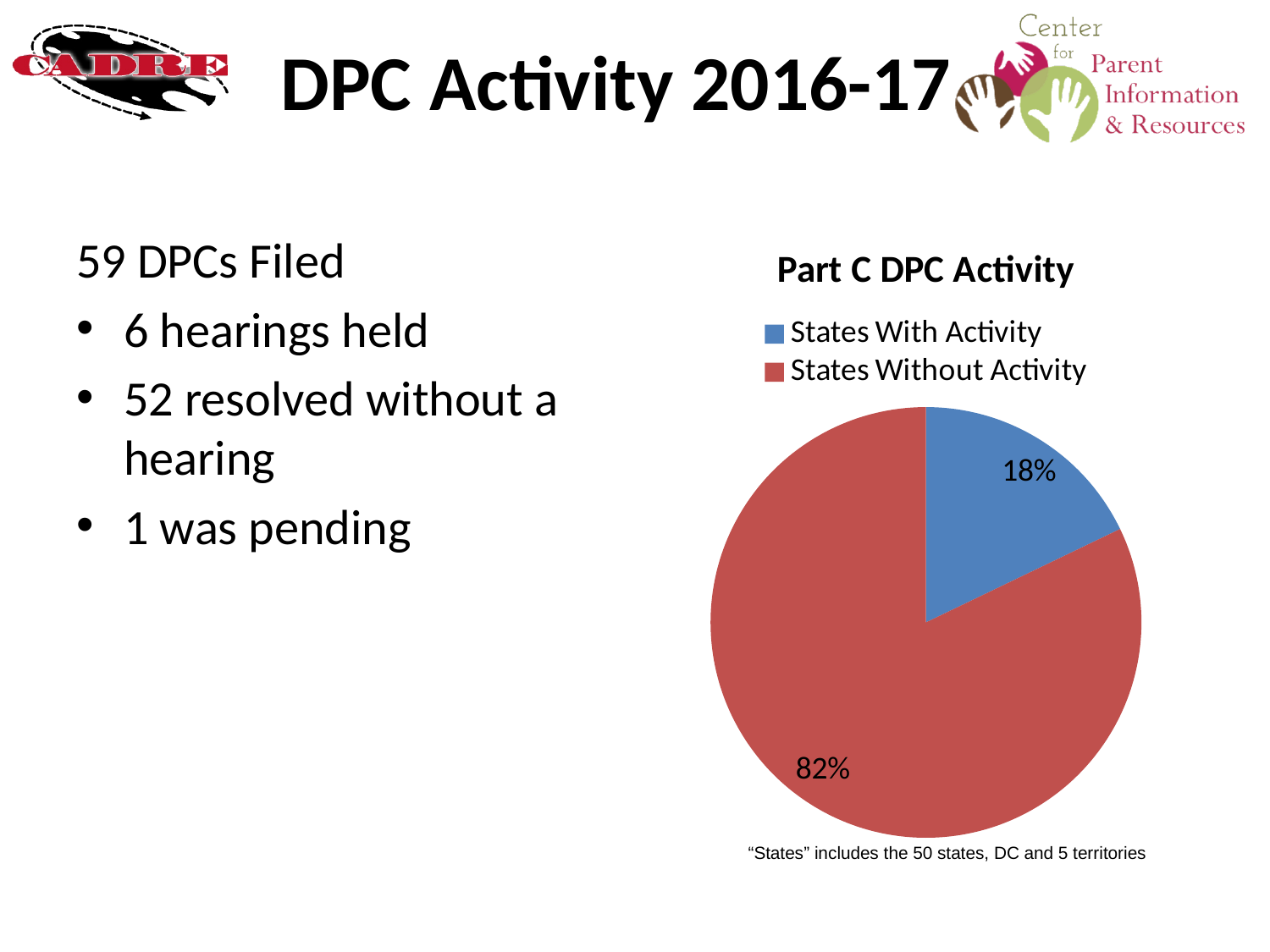
What is the difference in percentage points between States Without Activity and States With Activity? 64 What share of the pie is States Without Activity? 82% What type of chart is shown on the slide? pie chart What share of the pie is States With Activity? 18% Which slice of the pie is the largest? States Without Activity What colour is the States With Activity slice? blue How many entries does the legend list? 2 Which slice of the pie is the smallest? States With Activity Is the share for States With Activity greater or less than 50%? less How many slices does the pie chart have? 2 Which is larger, States With Activity or States Without Activity? States Without Activity What is the title of the chart? Part C DPC Activity